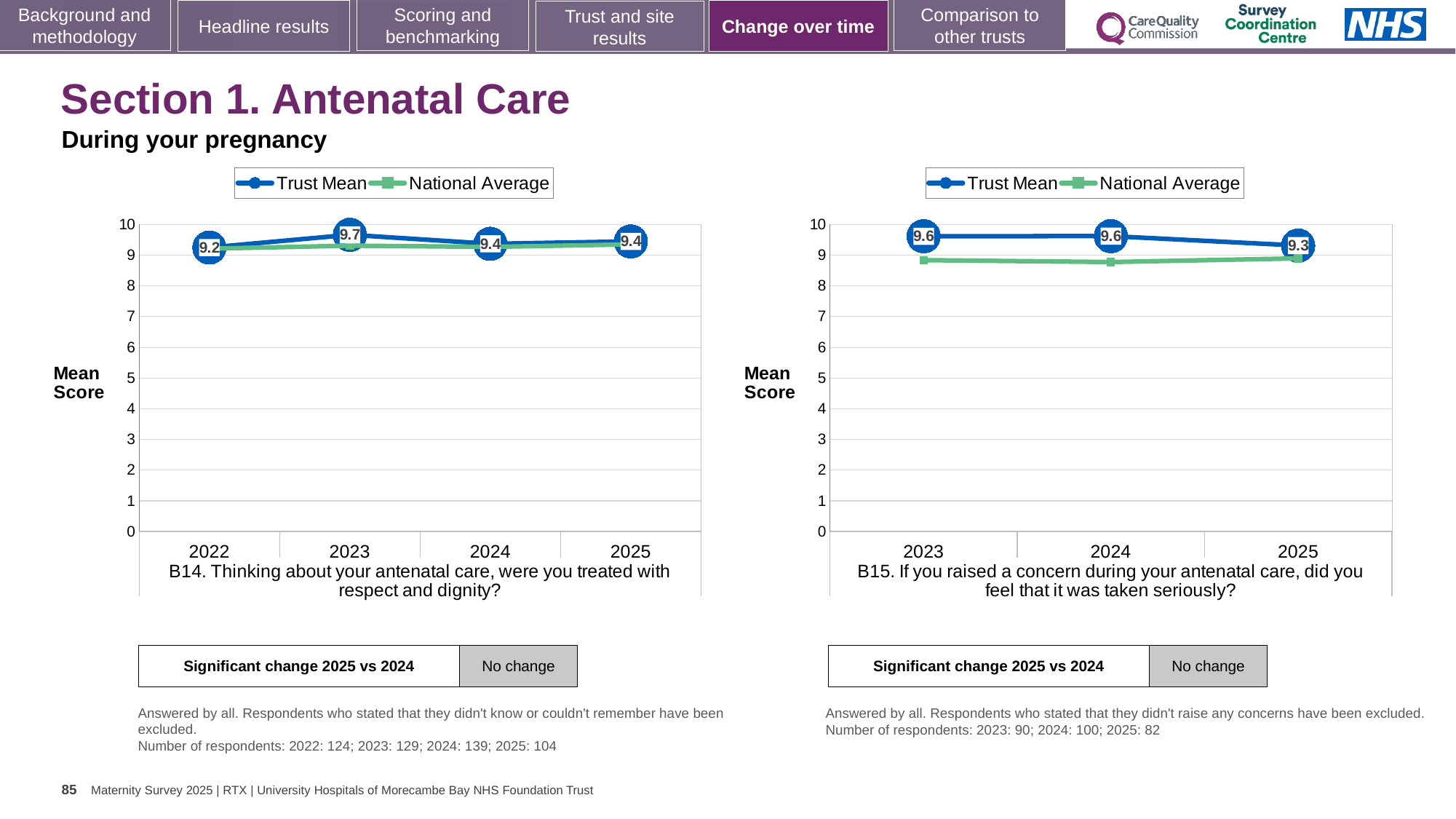
How many series does the legend of the B15 chart (right) list? 2 In the B14 chart (left), which year has the highest Trust Mean score? 2023 In the B15 chart (right), what is the difference between the Trust Mean scores for 2024 and 2025? 0.3 In the B15 chart (right), is the National Average value for 2024 greater or less than 8? greater In the B14 chart (left), what is the difference between the Trust Mean scores for 2023 and 2022? 0.5 What kind of chart is the B14 chart (left)? line chart How many years are plotted on the x axis of the B14 chart (left)? 4 In the B15 chart (right), what is the Trust Mean score for 2025? 9.3 In the B15 chart (right), which is larger, the Trust Mean for 2023 or the National Average for 2023? Trust Mean for 2023 In the B14 chart (left), which year has the lowest Trust Mean score? 2022 In the B15 chart (right), does the Trust Mean rise or fall from 2023 to 2025? fall In the B14 chart (left), what is the Trust Mean score for 2023? 9.7